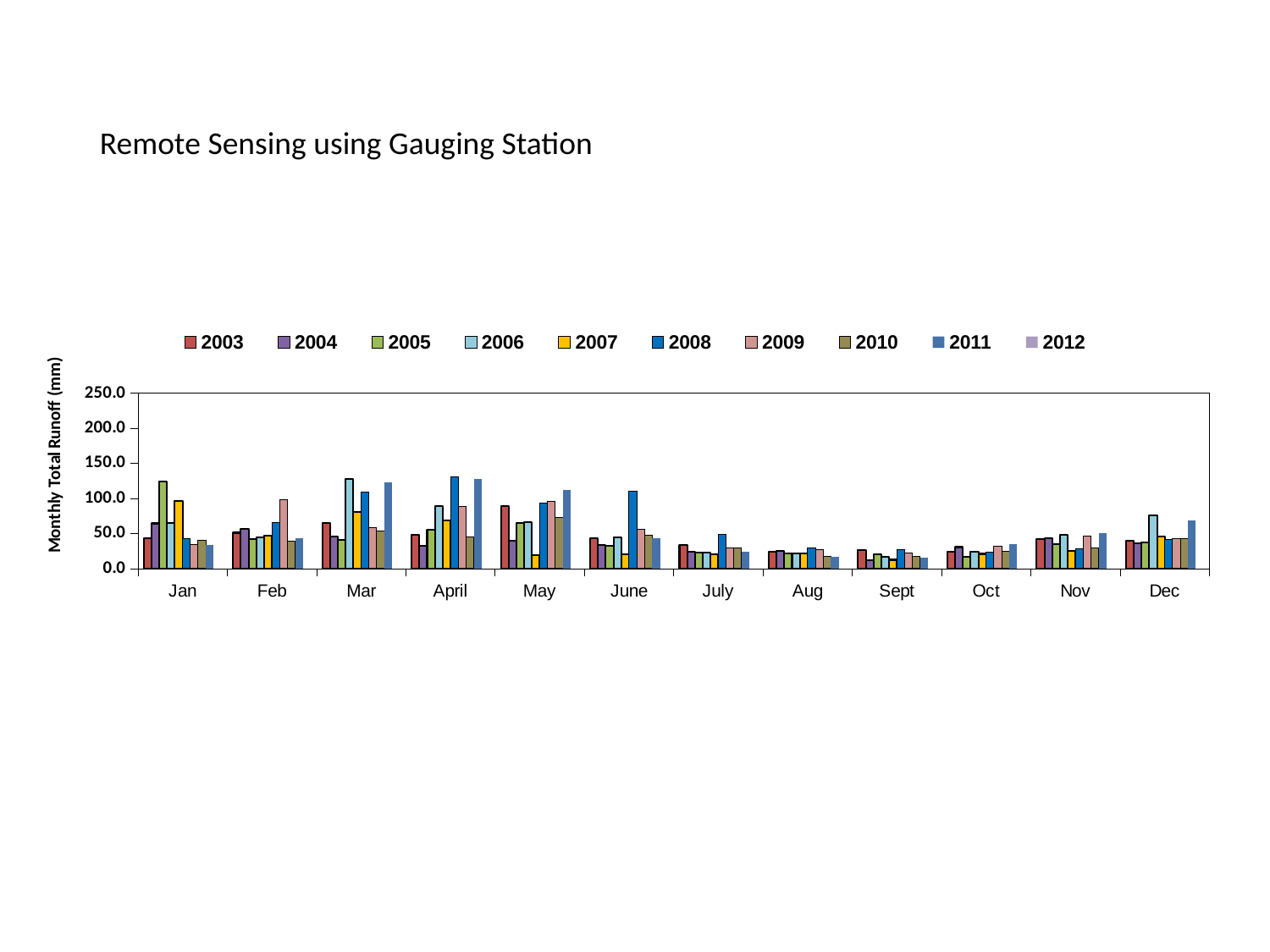
What kind of chart is shown on the slide? bar chart In Mar, which is larger: the value for 2003 or the value for 2006? 2006 How many months (categories) are shown along the x axis? 12 Which year has the lowest value in May? 2007 How many series does the legend list? 10 Which years are listed first and last in the legend? 2003 and 2012 Is the value for 2006 in Mar greater or less than 100? greater Is the value for 2005 in Jan greater or less than 100? greater Is the value for 2008 in June greater or less than 100? greater Which year has the highest value in Jan? 2005 What is the label of the y axis? Monthly Total Runoff (mm)